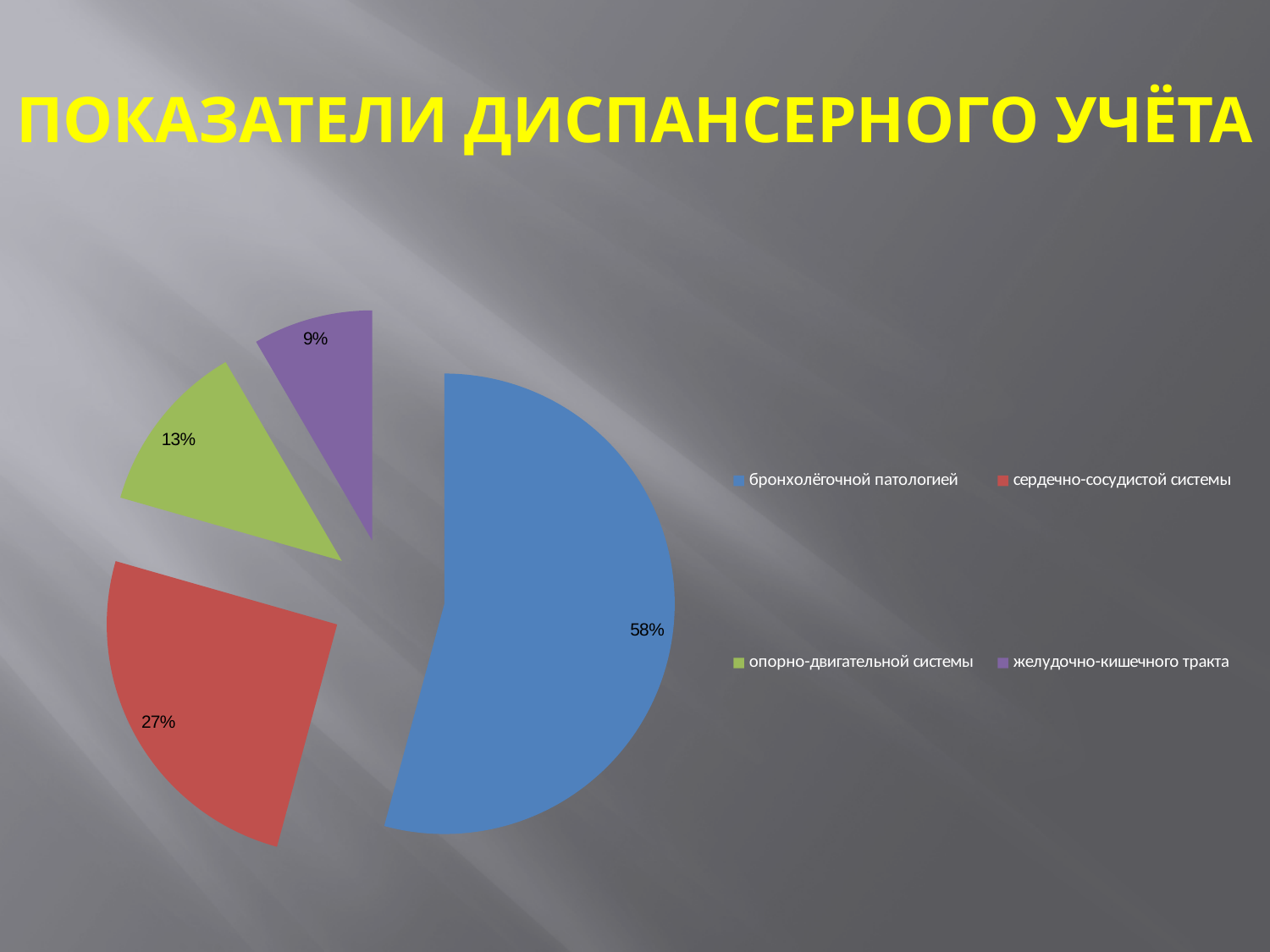
Which is larger: the slice for опорно-двигательной системы or the slice for желудочно-кишечного тракта? опорно-двигательной системы Which category has the smallest slice of the pie? желудочно-кишечного тракта What colour is the slice for сердечно-сосудистой системы? red What share of the pie does желудочно-кишечного тракта have? 9% What share of the pie does бронхолёгочной патологией have? 58% Which category has the largest slice of the pie? бронхолёгочной патологией What is the title of the slide? ПОКАЗАТЕЛИ ДИСПАНСЕРНОГО УЧЁТА What kind of chart is shown on the slide? pie chart What share of the pie does сердечно-сосудистой системы have? 27% What is the difference in percentage points between бронхолёгочной патологией and сердечно-сосудистой системы? 31 How many slices does the pie chart have? 4